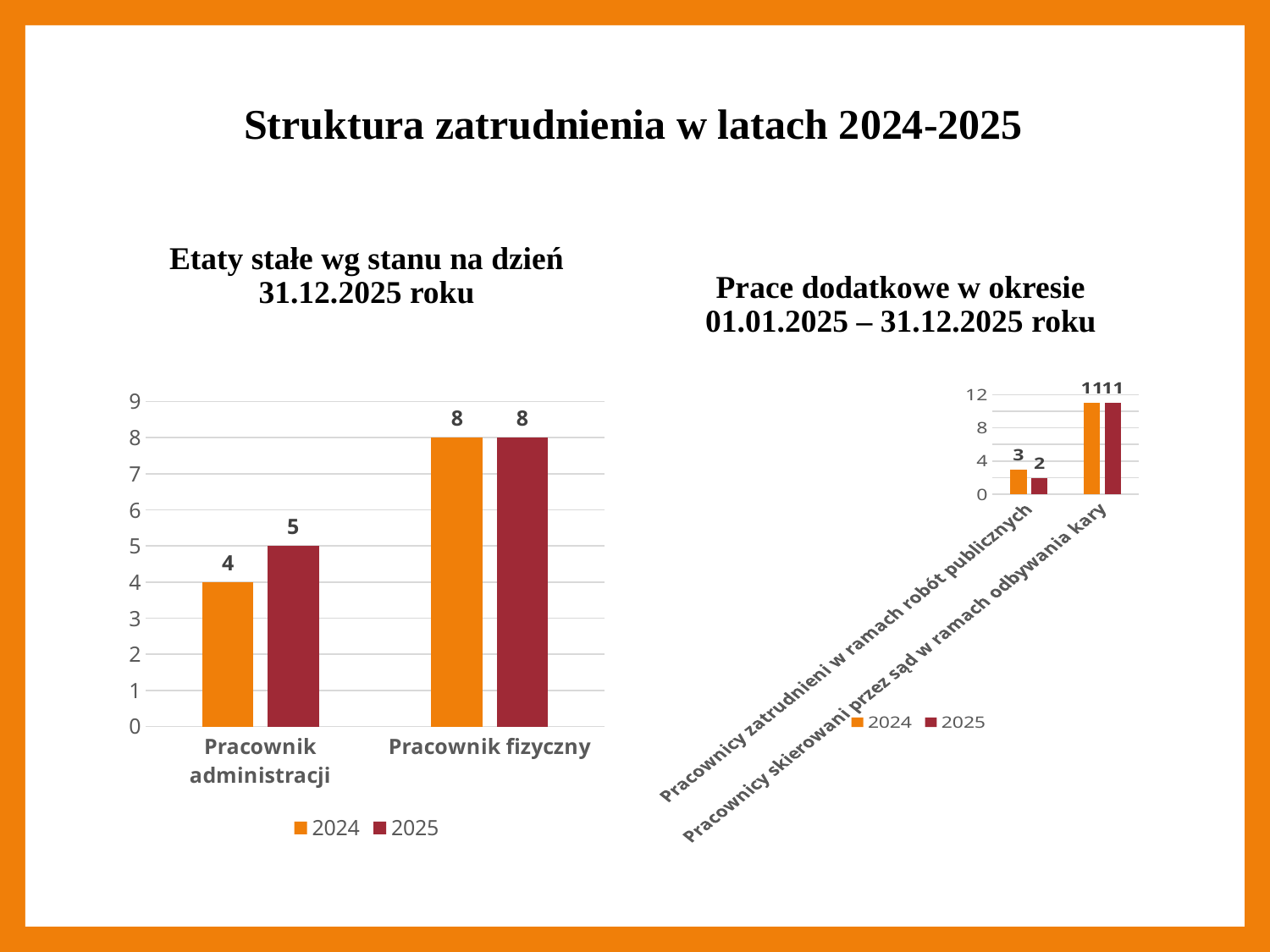
In the chart 'Etaty stałe wg stanu na dzień 31.12.2025 roku', what is the difference between the 2025 and 2024 values for Pracownik administracji? 1 In the chart 'Etaty stałe wg stanu na dzień 31.12.2025 roku', which category has the highest value in 2024? Pracownik fizyczny In the chart 'Prace dodatkowe w okresie 01.01.2025 – 31.12.2025 roku', which category has the highest value in 2025? Pracownicy skierowani przez sąd w ramach odbywania kary How many series does the legend of the chart 'Etaty stałe wg stanu na dzień 31.12.2025 roku' list? 2 In the chart 'Etaty stałe wg stanu na dzień 31.12.2025 roku', what is the value for Pracownik fizyczny in 2024? 8 In the chart 'Etaty stałe wg stanu na dzień 31.12.2025 roku', what is the value for Pracownik administracji in 2025? 5 In the chart 'Prace dodatkowe w okresie 01.01.2025 – 31.12.2025 roku', what is the 2024 value for Pracownicy zatrudnieni w ramach robót publicznych? 3 How many categories are shown on the x axis of the chart 'Prace dodatkowe w okresie 01.01.2025 – 31.12.2025 roku'? 2 In the chart 'Etaty stałe wg stanu na dzień 31.12.2025 roku', which colour represents the 2024 series? orange In the chart 'Prace dodatkowe w okresie 01.01.2025 – 31.12.2025 roku', what is the 2025 value for Pracownicy zatrudnieni w ramach robót publicznych? 2 What kind of chart is 'Etaty stałe wg stanu na dzień 31.12.2025 roku'? bar chart In the chart 'Etaty stałe wg stanu na dzień 31.12.2025 roku', is the 2024 value for Pracownik administracji larger or smaller than the 2025 value? smaller